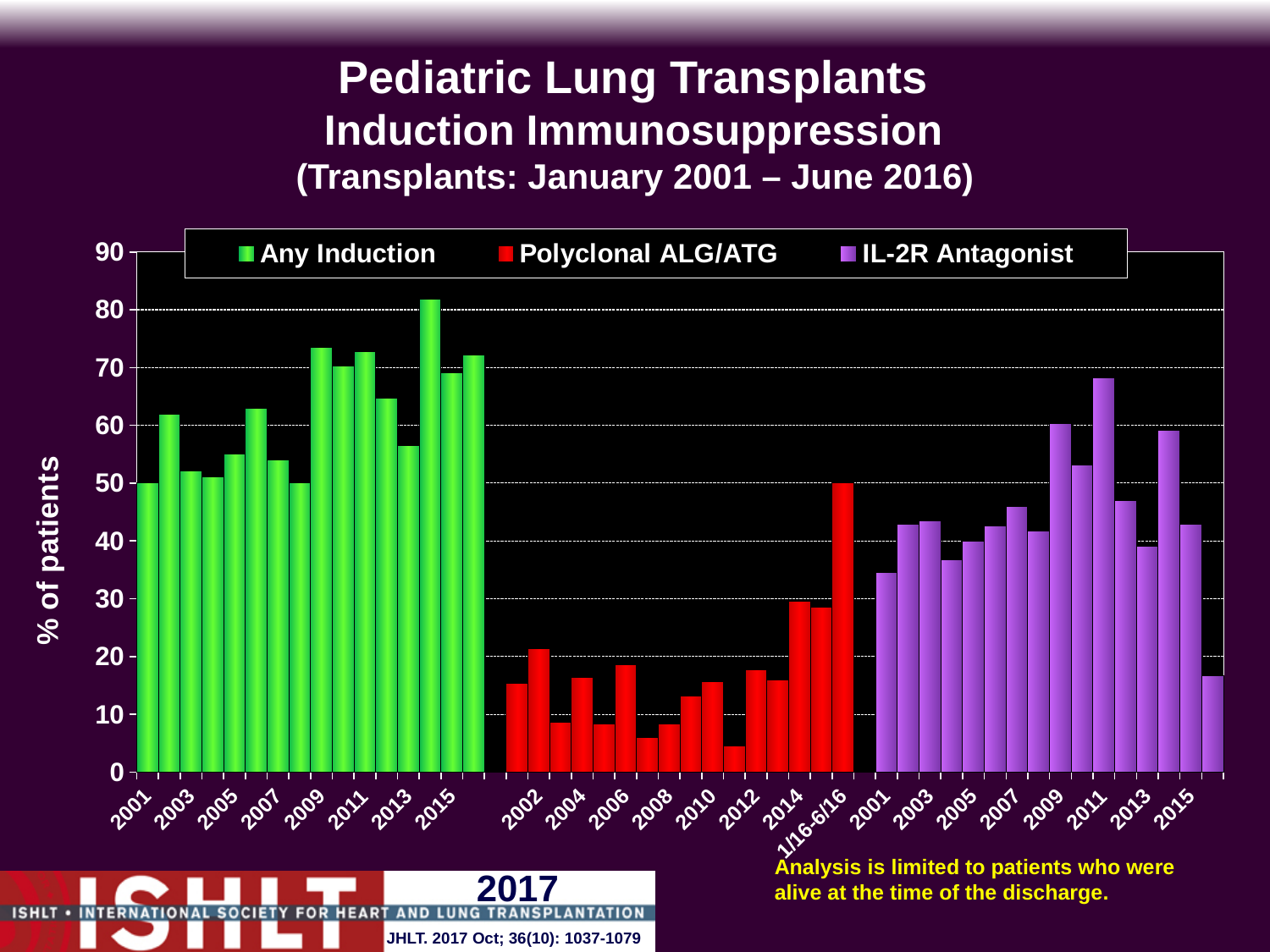
What kind of chart is shown on the slide? bar chart Is the value for Polyclonal ALG/ATG in 2002 greater or less than 20? greater Which year has the highest value for Any Induction? 2014 Is the value for IL-2R Antagonist in 2011 greater or less than 60? greater Which year has the lowest value for IL-2R Antagonist? 1/16-6/16 Which year has the highest value for IL-2R Antagonist? 2011 What is the label on the vertical axis? % of patients Which is larger for Any Induction: the value in 2014 or the value in 2015? 2014 Is the value for Any Induction in 2014 greater or less than 80? greater Which period has the highest value for Polyclonal ALG/ATG? 1/16-6/16 How many series does the legend list? 3 Do the Polyclonal ALG/ATG values rise or fall from 2013 to 1/16-6/16? rise